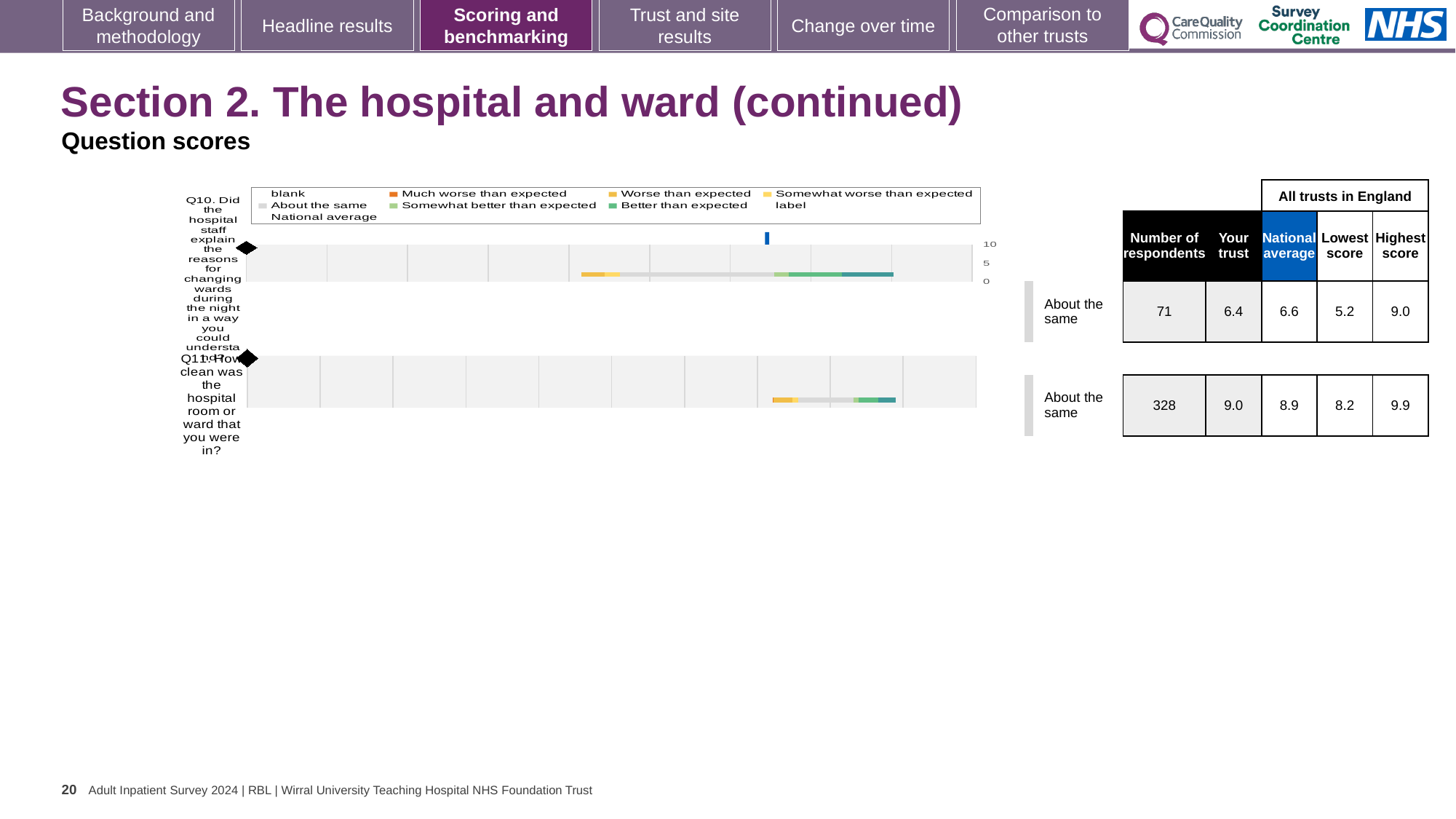
In the table beside the Q10 chart, what is the 'Your trust' score for Q10? 6.4 In the table beside the charts, which question has the higher 'Your trust' score, Q10 or Q11? Q11 In the table beside the charts, what is the highest score among all trusts in England for Q11? 9.9 How many entries does the chart legend list? 9 Which survey question does the top chart on the slide relate to? Q10 In the table beside the charts, what is the national average for Q11? 8.9 In the table beside the charts, how many respondents answered Q10? 71 In the table beside the charts, what is the difference between the 'Your trust' score and the national average for Q10? 0.2 In the table beside the Q11 chart, what is the 'Your trust' score for Q11? 9.0 What kind of chart is used to show the Q10 and Q11 question scores? bar chart How many survey questions (charts) are plotted on the slide? 2 What is the highest tick value shown on the chart's score axis? 10